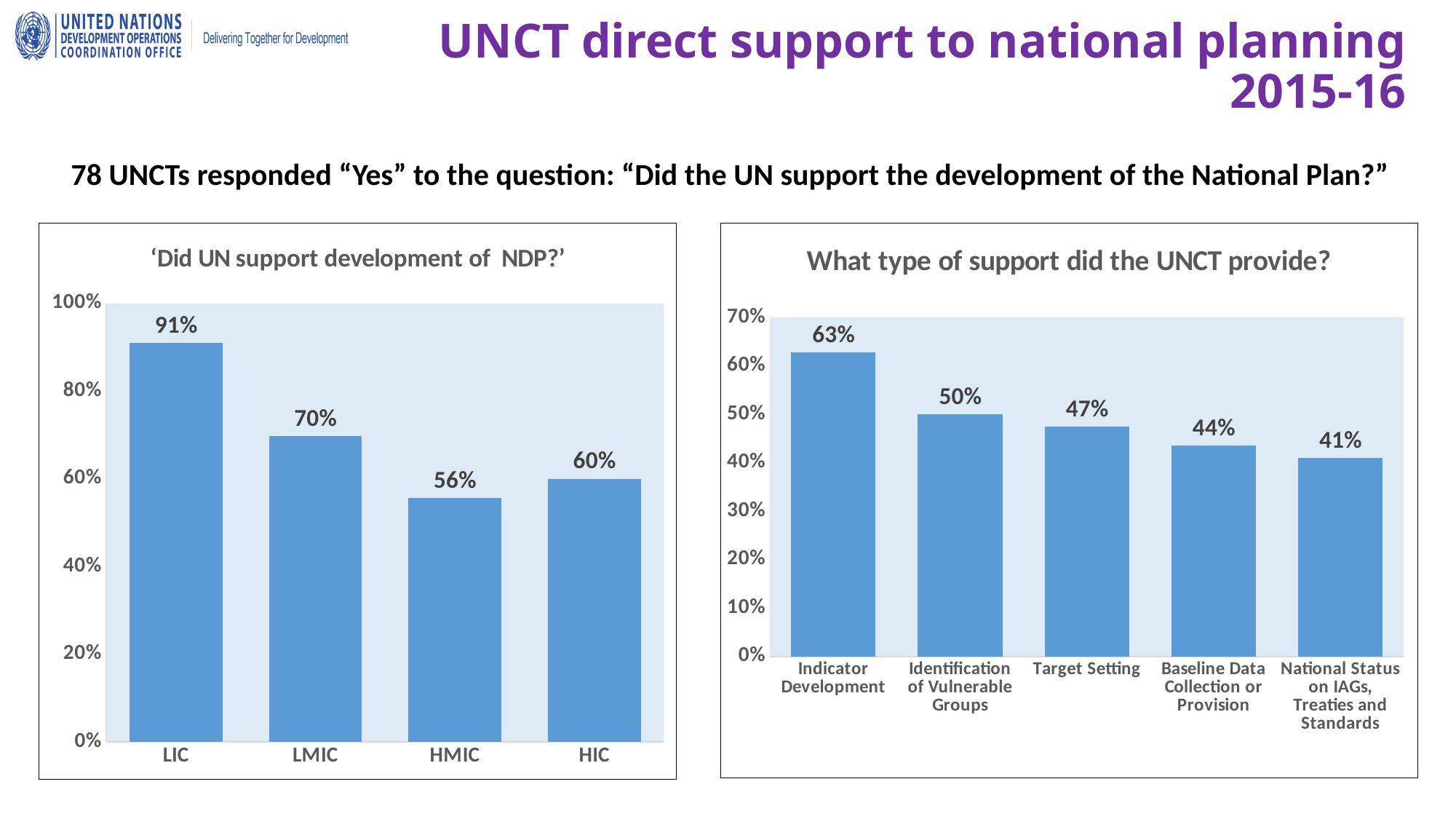
In the chart 'Did UN support development of NDP?', what is the value for LIC? 91% In the chart 'What type of support did the UNCT provide?', how many categories are shown? 5 In the chart 'What type of support did the UNCT provide?', what is the difference between Indicator Development and Baseline Data Collection or Provision? 19% In the chart 'Did UN support development of NDP?', what is the difference between the values for LIC and LMIC? 21% In the chart 'What type of support did the UNCT provide?', which category has the highest value? Indicator Development In the chart 'Did UN support development of NDP?', which category has the lowest value? HMIC What kind of chart is the chart on the left of the slide? bar chart In the chart 'What type of support did the UNCT provide?', what is the value for National Status on IAGs, Treaties and Standards? 41% In the chart 'What type of support did the UNCT provide?', do the values rise or fall from left to right? fall In the chart 'What type of support did the UNCT provide?', what is the value for Target Setting? 47% In the chart 'Did UN support development of NDP?', which is larger, the value for HMIC or the value for HIC? HIC In the chart 'Did UN support development of NDP?', how many categories are shown? 4